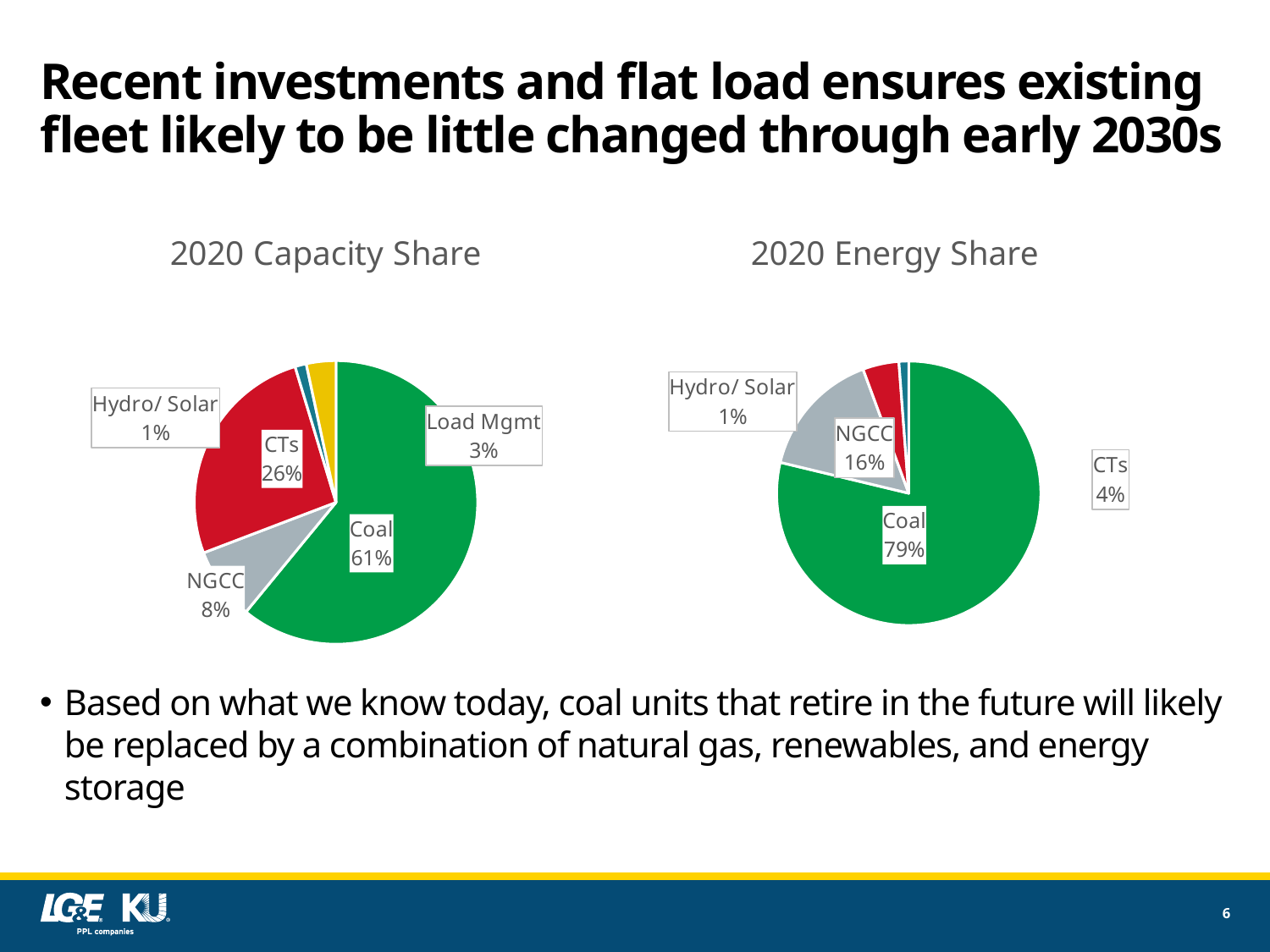
What kind of chart is the 2020 Energy Share chart? Pie chart In the 2020 Capacity Share chart, what share do CTs have? 26% In the 2020 Capacity Share chart, what share does Load Mgmt have? 3% In the 2020 Energy Share chart, what share do CTs have? 4% In the 2020 Capacity Share chart, what share does Coal have? 61% In the 2020 Capacity Share chart, what share does NGCC have? 8% In the 2020 Capacity Share chart, which is larger: the share for CTs or the share for NGCC? CTs In the 2020 Energy Share chart, what share does Coal have? 79% In the 2020 Energy Share chart, which category has the smallest share? Hydro/ Solar In the 2020 Energy Share chart, what share does NGCC have? 16% What is the difference between Coal's share in the 2020 Energy Share chart and Coal's share in the 2020 Capacity Share chart? 18% In the 2020 Capacity Share chart, which category has the largest share? Coal